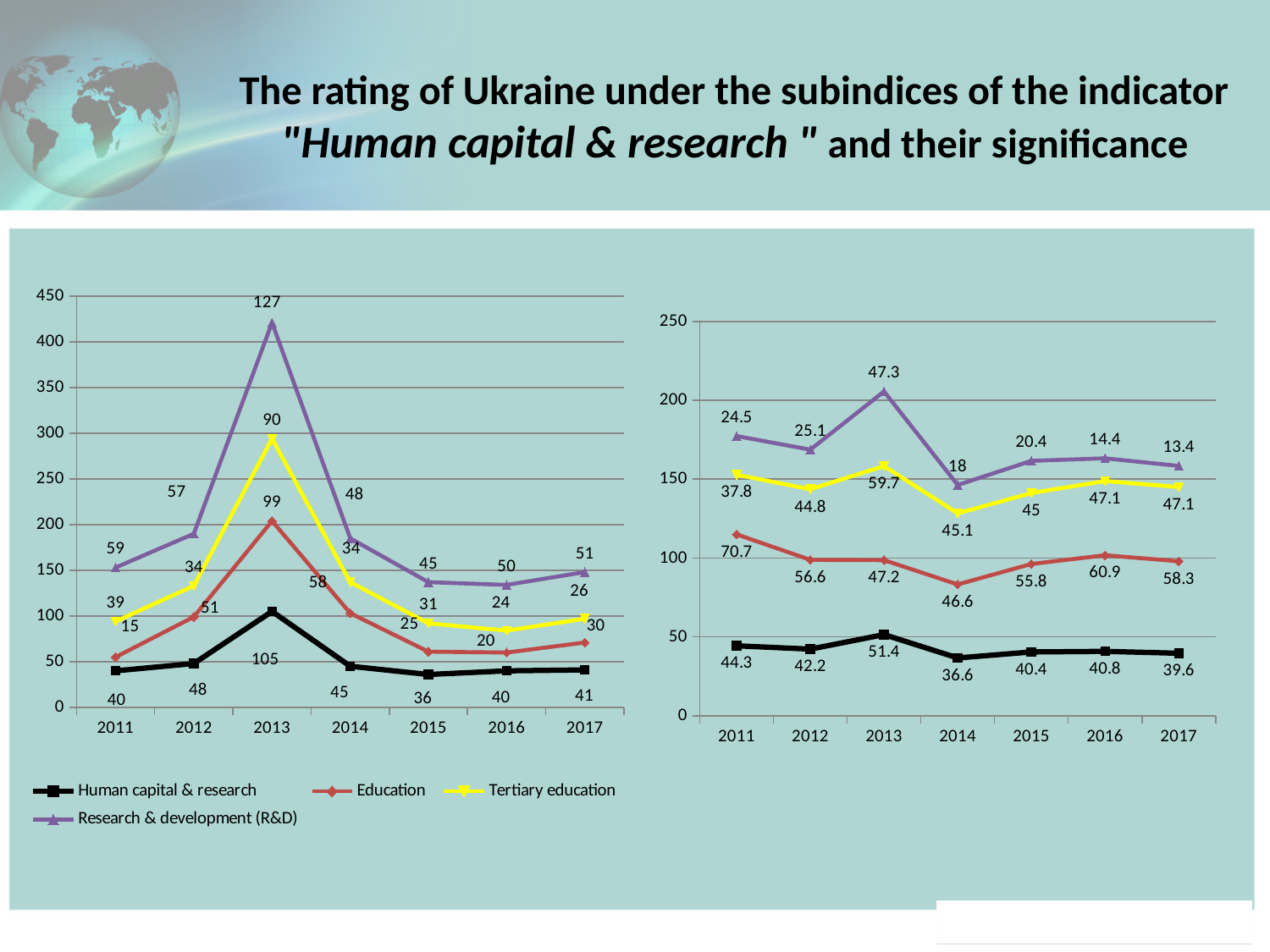
In the right chart, what is the value of the black line in 2013? 51.4 In the left chart, what is the value for Human capital & research in 2013? 105 In the left chart, in which year is the Tertiary education value highest? 2013 How many years are shown on the x axis of the left chart? 7 In the left chart, in which year is the Human capital & research value lowest? 2015 In the right chart, what is the value of the purple line in 2017? 13.4 In the left chart, what is the difference between the Education values in 2013 and 2014? 41 How many series does the legend of the left chart list? 4 In the right chart, which is larger: the red line value in 2011 or in 2012? 2011 What kind of chart is the right chart? Line chart In the left chart, what is the value for Education in 2015? 25 In the left chart, what is the value for Research & development (R&D) in 2011? 59